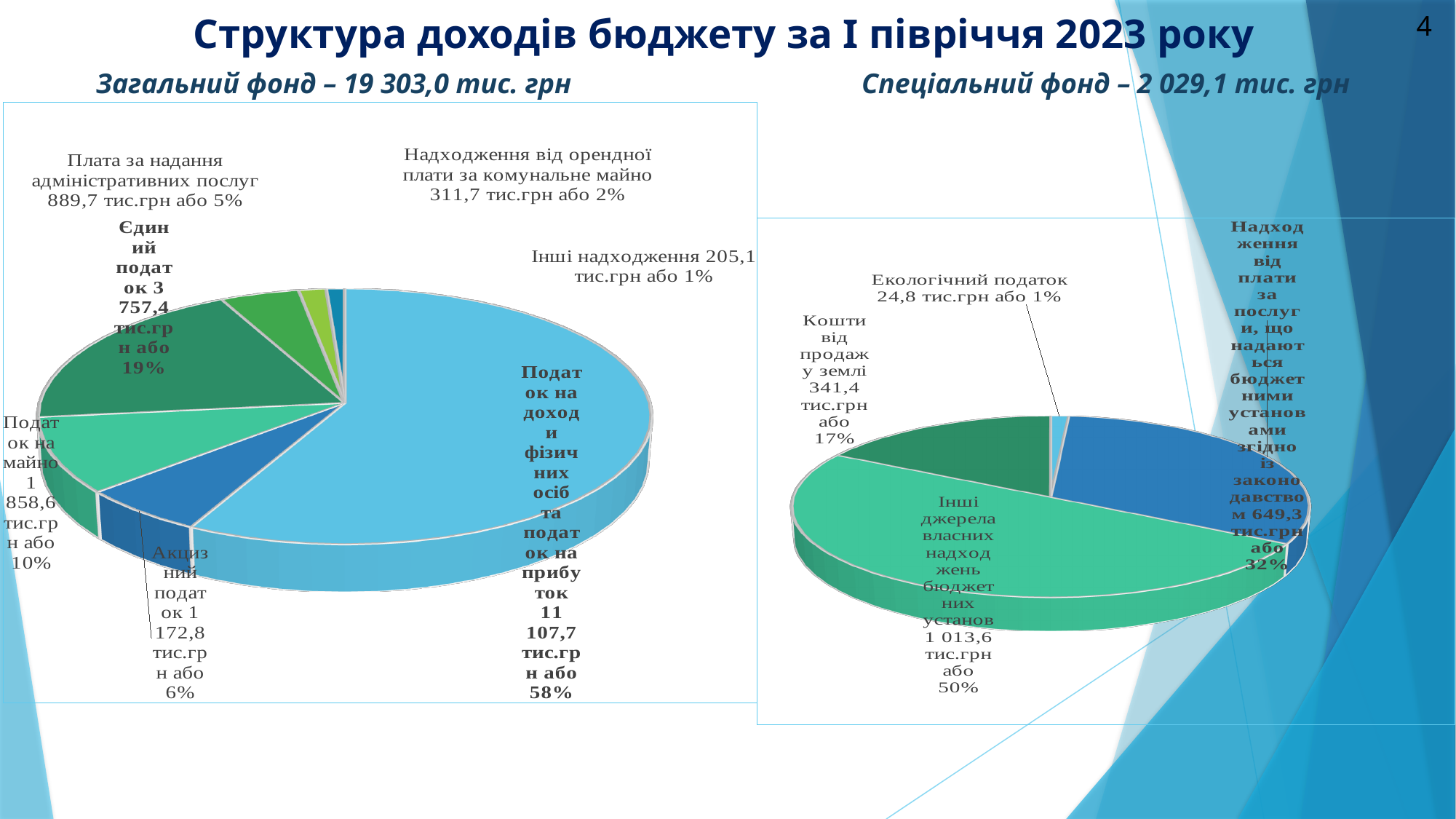
On the 'Спеціальний фонд' pie chart, which category has the smallest slice? Екологічний податок On the 'Загальний фонд' pie chart, how many slices are there? 7 On the 'Загальний фонд' pie chart, which is larger: 'Податок на майно' or 'Акцизний податок'? Податок на майно On the 'Загальний фонд' pie chart, what share does 'Податок на доходи фізичних осіб та податок на прибуток' have? 58% On the 'Загальний фонд' pie chart, what is the value for 'Єдиний податок'? 3 757,4 тис.грн What type of chart is used for the 'Спеціальний фонд' data? Pie chart On the 'Спеціальний фонд' pie chart, what share does 'Інші джерела власних надходжень бюджетних установ' have? 50% On the 'Загальний фонд' pie chart, which category has the largest slice? Податок на доходи фізичних осіб та податок на прибуток On the 'Загальний фонд' pie chart, what is the difference in percentage points between 'Єдиний податок' and 'Податок на майно'? 9 percentage points On the 'Спеціальний фонд' pie chart, how many slices are there? 4 On the 'Спеціальний фонд' pie chart, what is the value for 'Кошти від продажу землі'? 341,4 тис.грн On the 'Загальний фонд' pie chart, which category has the smallest slice? Інші надходження